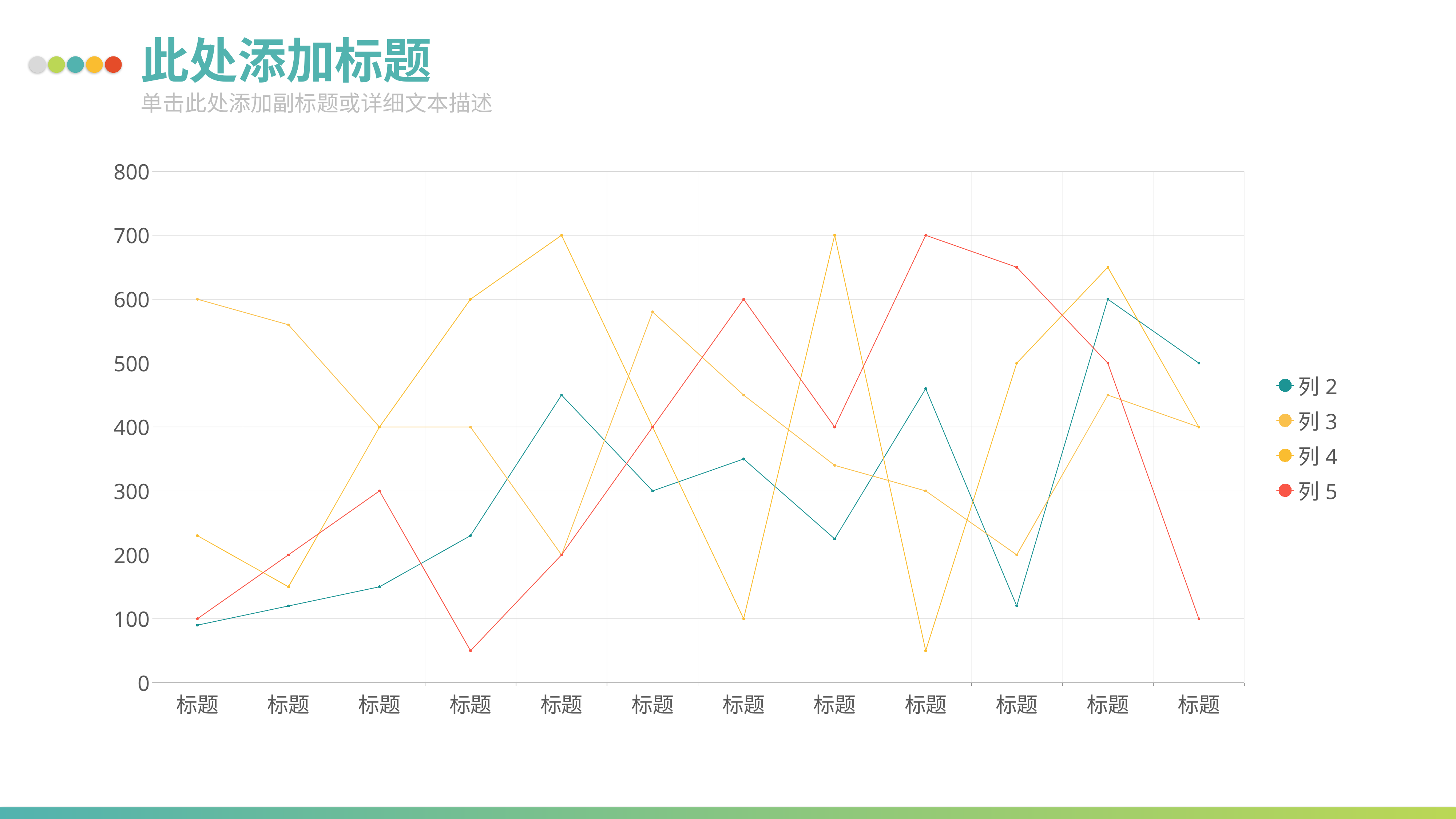
Does 列 5 rise or fall from the first category to the third category? rise What is the value of 列 5 at the first category? 100 What kind of chart is shown on the slide? line chart Which series reaches the highest value on the chart, 列 2 or 列 5? 列 5 How many categories are plotted along the x axis? 12 At which category position does 列 5 reach its lowest value? 4th Is the value for 列 2 at the 11th category greater or less than 500? greater At which category position does 列 5 reach its highest value? 9th How many series does the legend list? 4 At the last category, which is larger, 列 2 or 列 5? 列 2 What is the value of 列 2 at the last (12th) category? 500 What is the value of 列 5 at the last (12th) category? 100